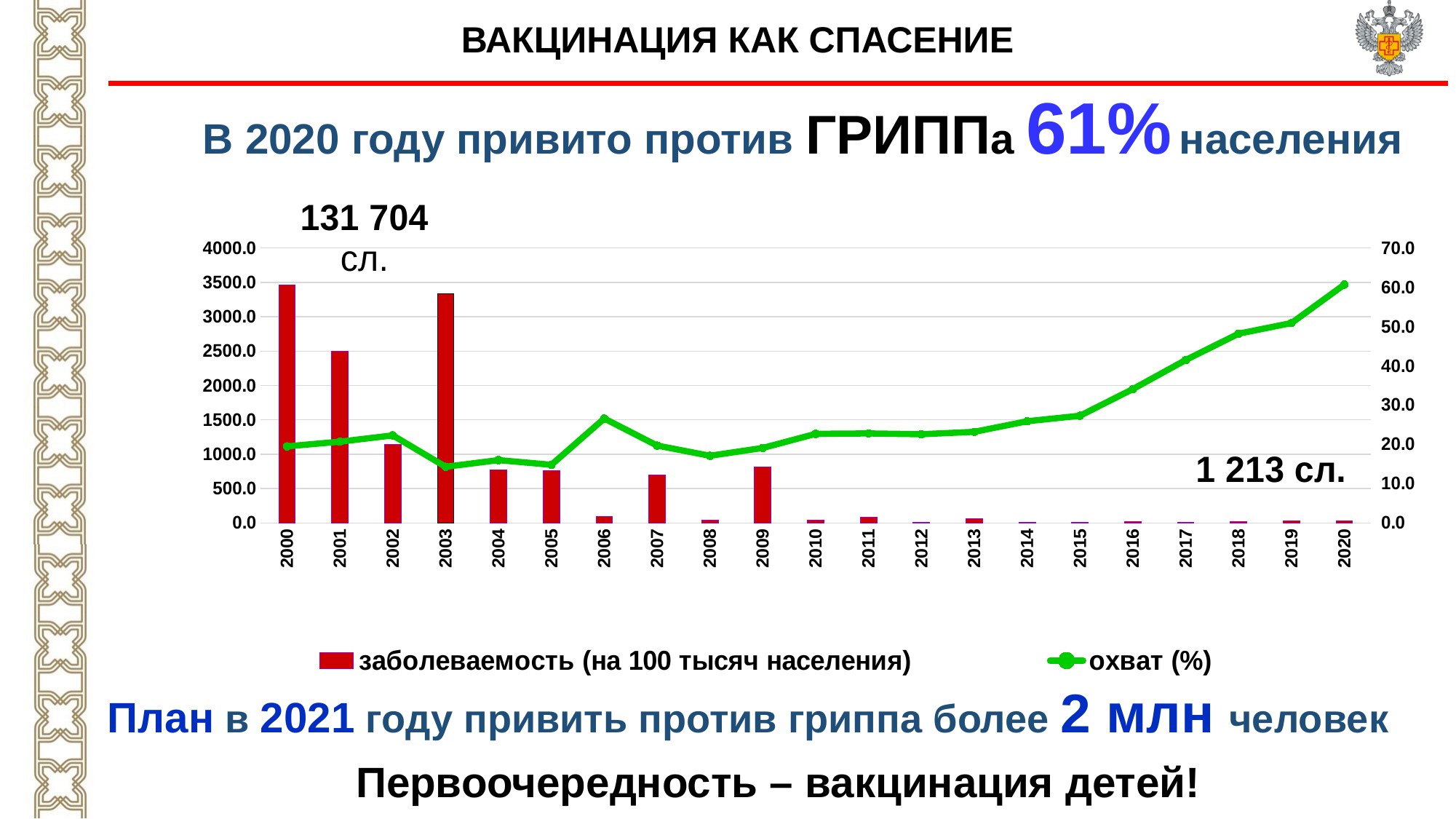
What kind of chart is shown on the slide? A combined bar and line chart How many series does the chart legend list? 2 Is the охват (%) value for 2020 greater or less than 50? greater Is the заболеваемость bar for 2002 greater or less than 1500? less Is the заболеваемость bar for 2000 greater or less than 3000? greater Does the охват (%) line rise or fall from 2015 to 2020? It rises What is the first legend entry of the chart? заболеваемость (на 100 тысяч населения) Which year has the higher заболеваемость bar, 2000 or 2001? 2000 What colour is the охват (%) line in the chart? Green How many years are shown along the x axis of the chart? 21 Which year has the highest value for охват (%)? 2020